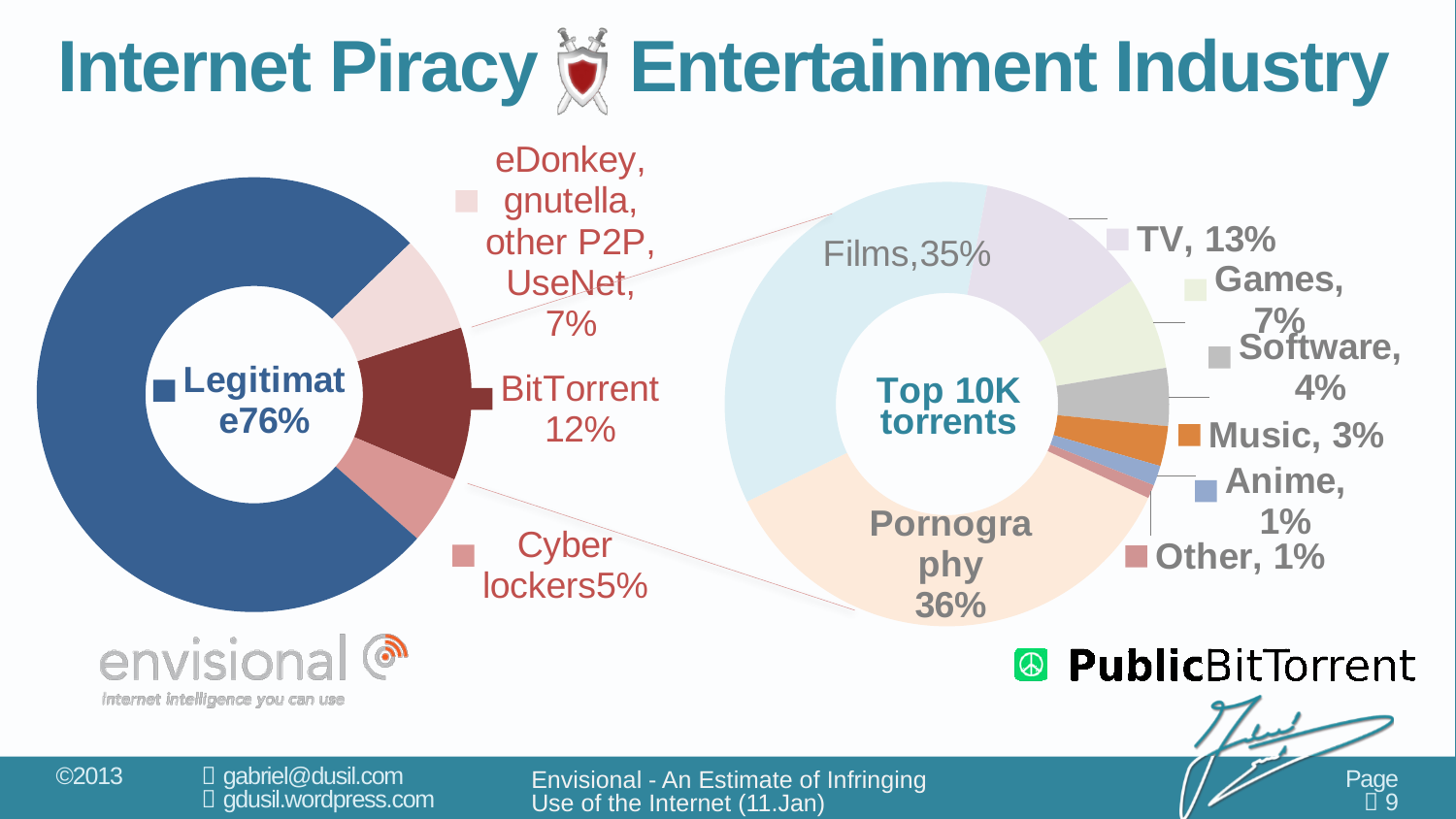
In the left donut chart, which category has the largest share? Legitimate In the right 'Top 10K torrents' chart, what is the difference between Pornography and Films? 1% In the right 'Top 10K torrents' chart, which is larger, Games or Software? Games In the right 'Top 10K torrents' chart, which category has the largest share? Pornography In the left donut chart, what share is labelled Legitimate? 76% In the right 'Top 10K torrents' chart, what is the value for TV? 13% In the right 'Top 10K torrents' chart, what is the value for Films? 35% In the left donut chart, how many categories are shown? 4 In the left donut chart, what is the difference between the BitTorrent share and the Cyber lockers share? 7% In the left donut chart, what is the value for BitTorrent? 12% In the left donut chart, what is the value for Cyber lockers? 5% What type of chart is used on the right side of the slide? Donut (pie) chart